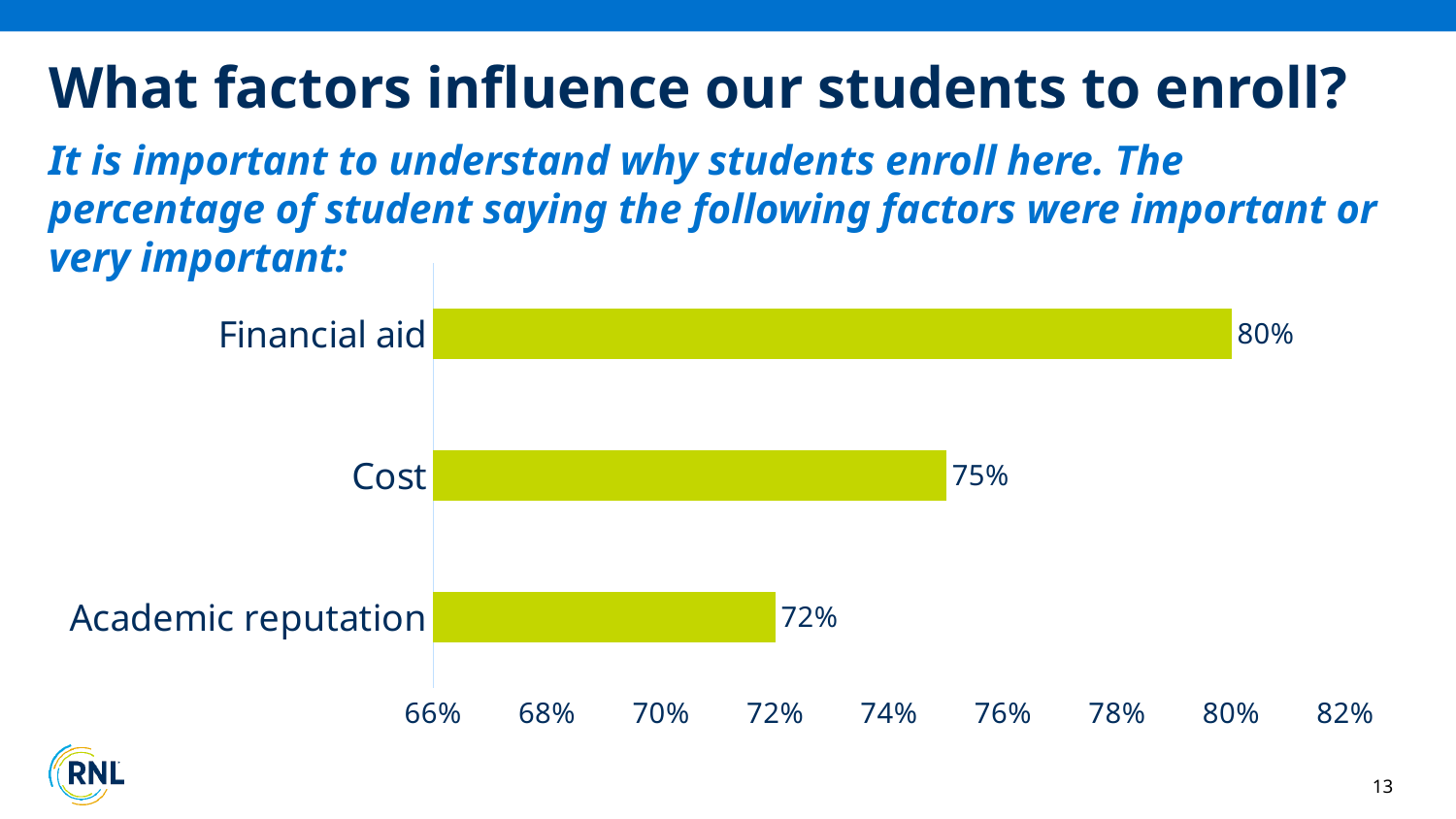
Is the value for Cost greater or less than 74%? greater What kind of chart is shown on the slide? Bar chart What is the highest value shown on the x axis? 82% What is the difference in percentage points between Financial aid and Cost? 5 Which is larger, the value for Cost or the value for Academic reputation? Cost Which factor has the highest percentage? Financial aid What is the value shown for Academic reputation? 72% How many factors are shown in the chart? 3 What is the value shown for Cost? 75% What is the difference in percentage points between Financial aid and Academic reputation? 8 What percentage of students said Financial aid was important or very important? 80% Which factor has the lowest percentage? Academic reputation